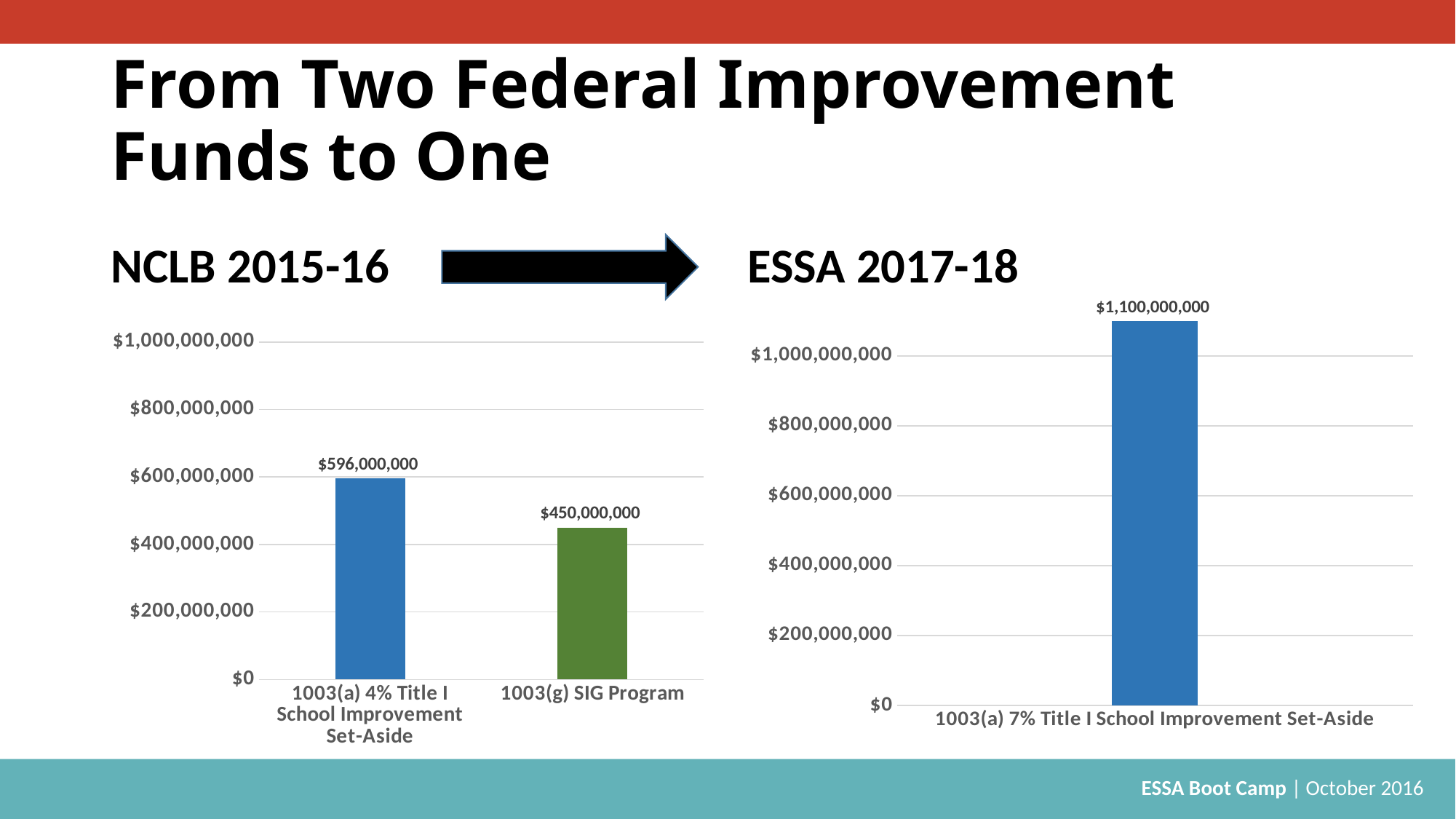
In the NCLB 2015-16 chart, what is the difference between the 1003(a) 4% Title I School Improvement Set-Aside and the 1003(g) SIG Program? $146,000,000 In the ESSA 2017-18 chart, is the value for 1003(a) 7% Title I School Improvement Set-Aside greater or less than $1,000,000,000? greater In the NCLB 2015-16 chart, which is larger: 1003(a) 4% Title I School Improvement Set-Aside or 1003(g) SIG Program? 1003(a) 4% Title I School Improvement Set-Aside What kind of chart is the ESSA 2017-18 chart? bar chart How many bars are in the NCLB 2015-16 chart? 2 In the NCLB 2015-16 chart, is the value for 1003(g) SIG Program greater or less than $600,000,000? less In the ESSA 2017-18 chart, what is the value for 1003(a) 7% Title I School Improvement Set-Aside? $1,100,000,000 In the NCLB 2015-16 chart, what is the value for 1003(a) 4% Title I School Improvement Set-Aside? $596,000,000 In the NCLB 2015-16 chart, which category has the lowest value? 1003(g) SIG Program What is the total of the two bars in the NCLB 2015-16 chart? $1,046,000,000 In the NCLB 2015-16 chart, what is the value for 1003(g) SIG Program? $450,000,000 In the NCLB 2015-16 chart, which category has the highest value? 1003(a) 4% Title I School Improvement Set-Aside